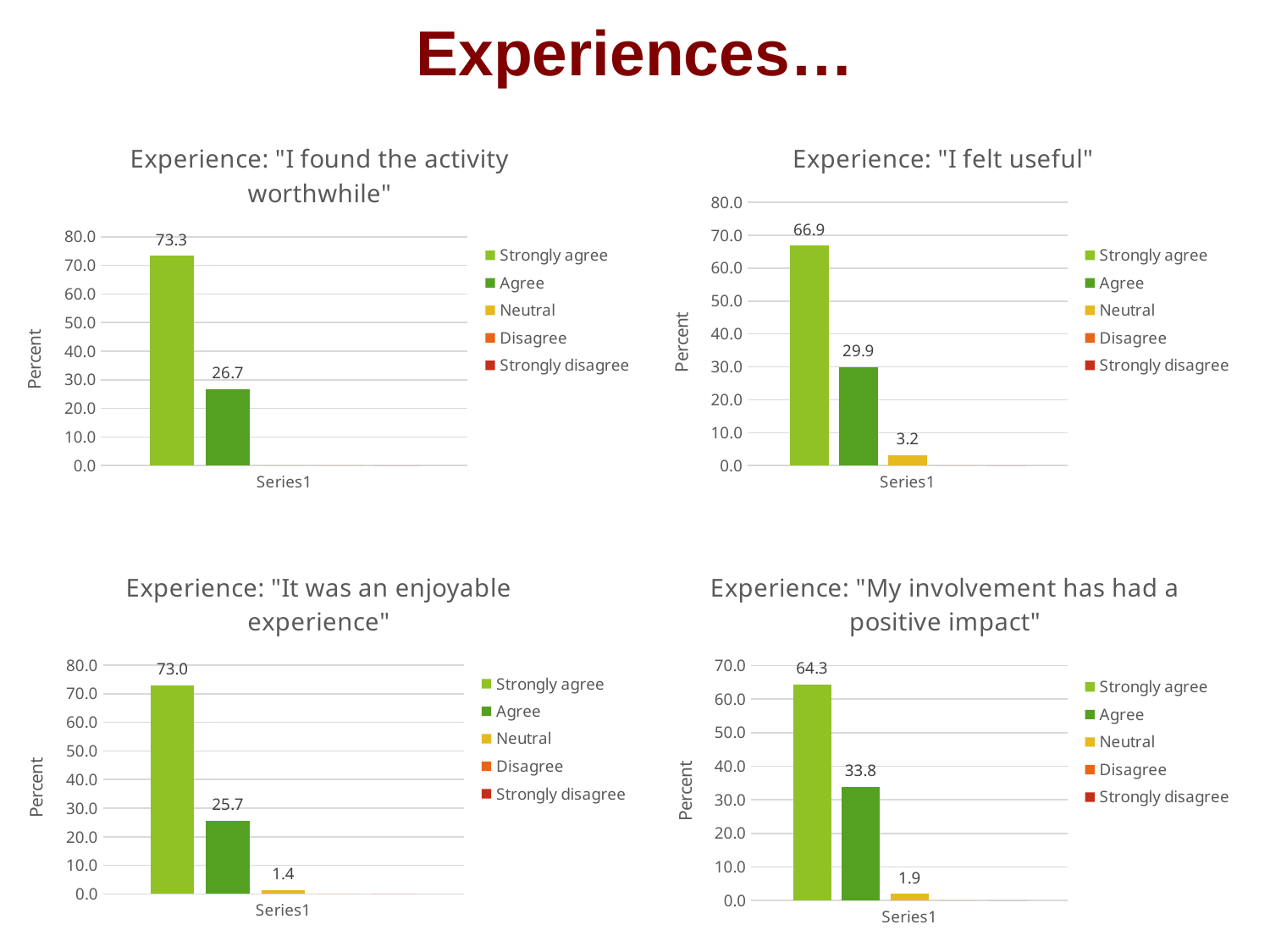
In the chart titled Experience: "It was an enjoyable experience", what is the value for Agree? 25.7 In the chart titled Experience: "I found the activity worthwhile", what is the difference between the Strongly agree and Agree values? 46.6 How many series does the legend list in the chart titled Experience: "I found the activity worthwhile"? 5 What is the y-axis label of the chart titled Experience: "It was an enjoyable experience"? Percent In the chart titled Experience: "I found the activity worthwhile", what is the value for Strongly agree? 73.3 In the chart titled Experience: "I felt useful", what is the value for Neutral? 3.2 In the chart titled Experience: "My involvement has had a positive impact", what is the value for Strongly agree? 64.3 What kind of chart is the chart titled Experience: "My involvement has had a positive impact"? bar chart In the chart titled Experience: "I felt useful", is the value for Agree greater or less than 20.0? greater In the chart titled Experience: "My involvement has had a positive impact", what is the difference between the Strongly agree and Agree values? 30.5 In the chart titled Experience: "I felt useful", which series has the highest value? Strongly agree In the chart titled Experience: "It was an enjoyable experience", which is larger, the Strongly agree value or the Agree value? Strongly agree